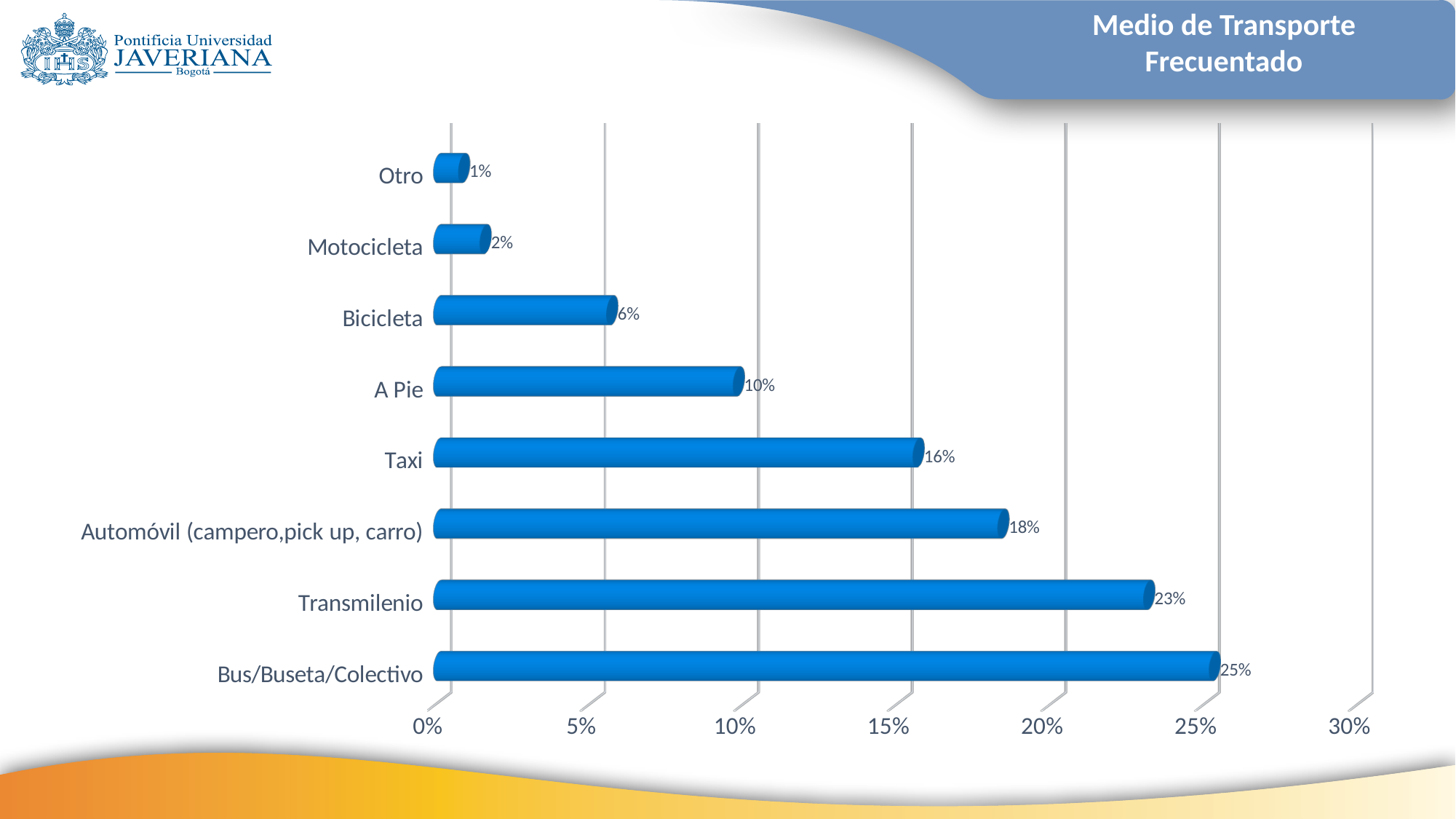
What is the title of the slide? Medio de Transporte Frecuentado What is the difference between the values for Automóvil (campero,pick up, carro) and A Pie? 8% Which category has the highest value? Bus/Buseta/Colectivo What is the value for Transmilenio? 23% What is the value for Bicicleta? 6% How many categories are shown in the chart? 8 Which is larger, the value for Taxi or the value for A Pie? Taxi What kind of chart is shown on the slide? bar chart Is the value for Automóvil (campero,pick up, carro) greater or less than 15%? greater Which category has the lowest value? Otro What is the value for Taxi? 16% What is the difference between the values for Bus/Buseta/Colectivo and Transmilenio? 2%